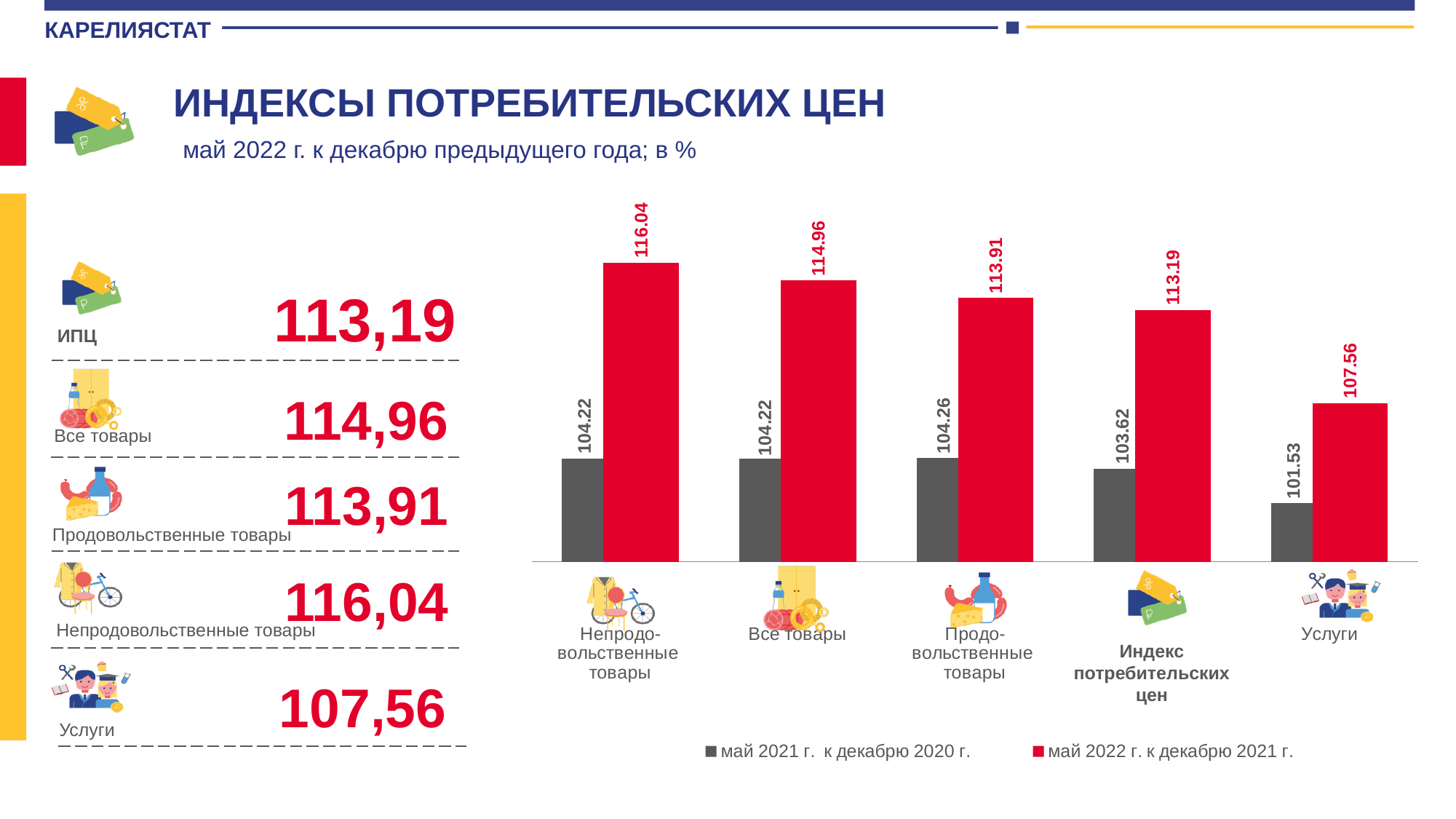
How many series does the chart legend list? 2 What is the value for Продовольственные товары in the series 'май 2021 г. к декабрю 2020 г.'? 104.26 How many categories are shown on the x axis of the chart? 5 Do the values of the series 'май 2022 г. к декабрю 2021 г.' rise or fall from left to right along the x axis? fall For Услуги, what is the difference between the 'май 2022 г. к декабрю 2021 г.' value and the 'май 2021 г. к декабрю 2020 г.' value? 6.03 What is the value for Услуги in the series 'май 2022 г. к декабрю 2021 г.'? 107.56 What kind of chart is shown on the slide? bar chart Which category has the highest value in the series 'май 2022 г. к декабрю 2021 г.'? Непродовольственные товары In the series 'май 2022 г. к декабрю 2021 г.', which is larger: Все товары or Продовольственные товары? Все товары For Непродовольственные товары, what is the difference between the 'май 2022 г. к декабрю 2021 г.' value and the 'май 2021 г. к декабрю 2020 г.' value? 11.82 What is the value for Индекс потребительских цен in the series 'май 2021 г. к декабрю 2020 г.'? 103.62 Which category has the lowest value in the series 'май 2021 г. к декабрю 2020 г.'? Услуги